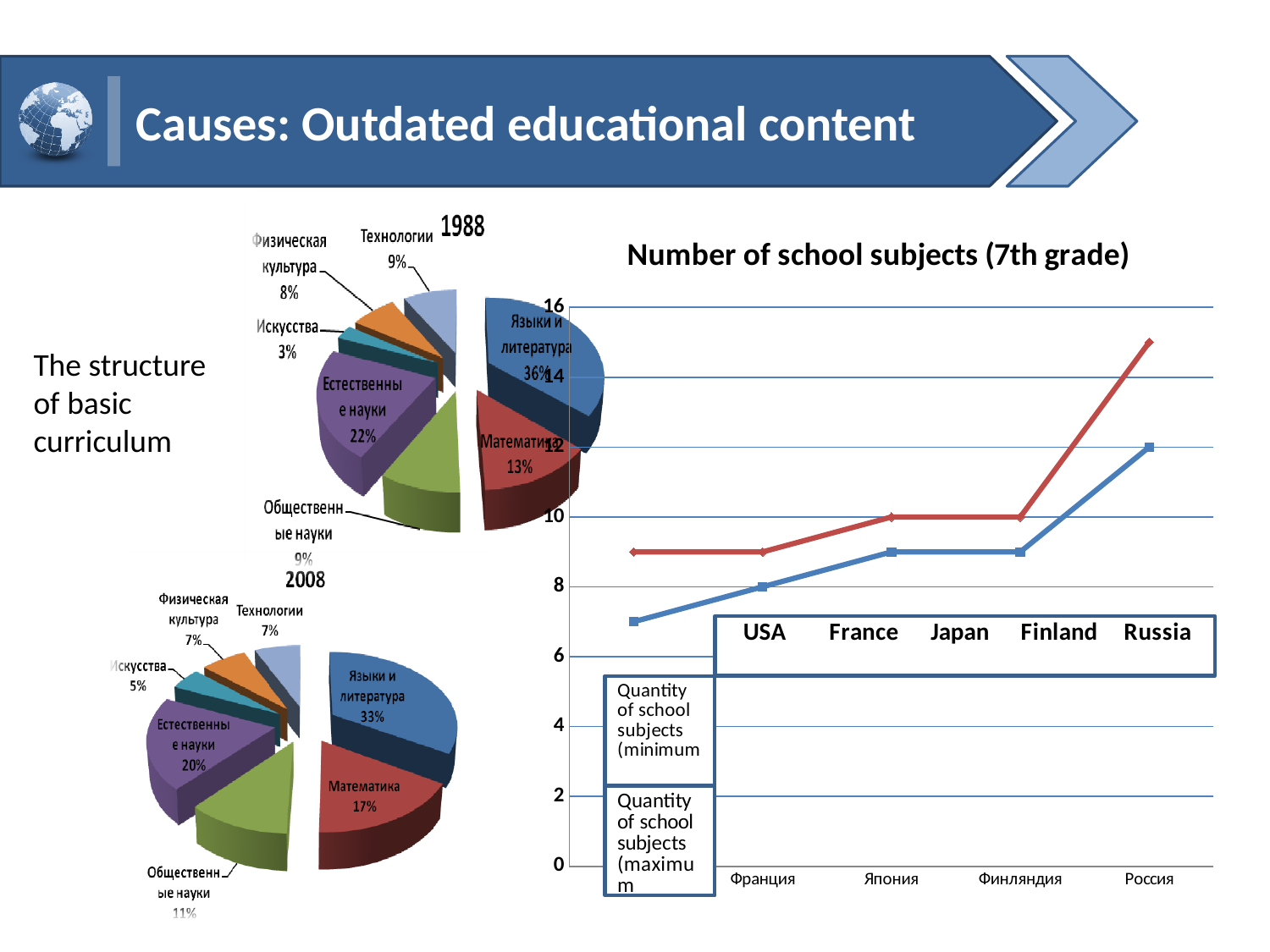
In the 2008 pie chart, which category has the smallest share? Искусства In the 'Number of school subjects (7th grade)' chart, what kind of chart is shown? Line chart In the 1988 pie chart, what share does Математика have? 13% In the 'Number of school subjects (7th grade)' chart, is the maximum quantity of school subjects for Russia greater or less than 14? greater In the 'Number of school subjects (7th grade)' chart, which country has the highest maximum quantity of school subjects? Russia In the 'Number of school subjects (7th grade)' chart, what is the minimum quantity of school subjects for Russia? 12 In the 2008 pie chart, what share does Естественные науки have? 20% In the 1988 pie chart, which category has the largest share? Языки и литература In the 'Number of school subjects (7th grade)' chart, what is the maximum quantity of school subjects for Japan? 10 By how many percentage points did the share of Математика change from the 1988 pie chart to the 2008 pie chart? 4% How many slices does the 2008 pie chart have? 7